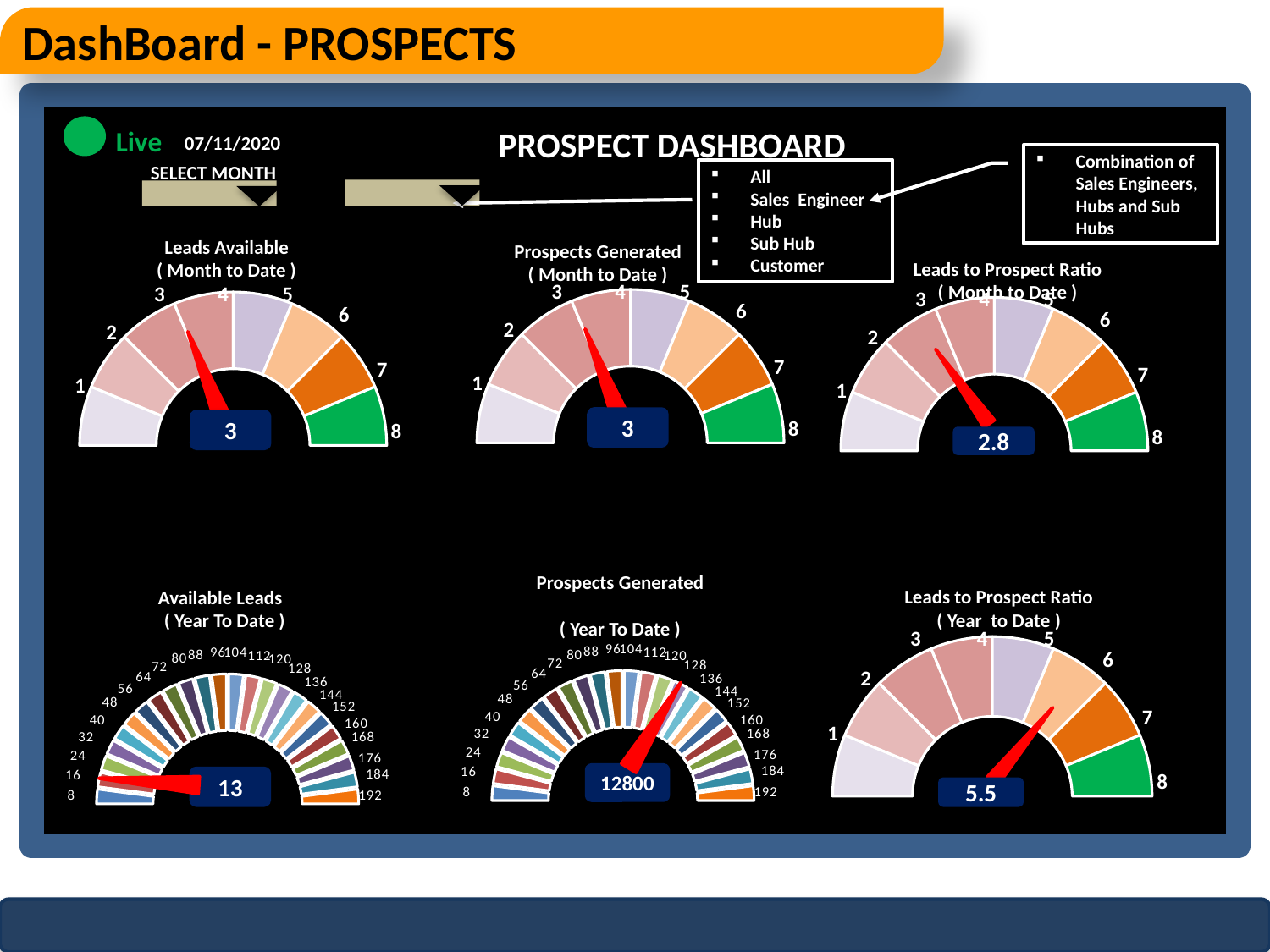
What value is shown on the 'Leads to Prospect Ratio (Month to Date)' gauge? 2.8 What kind of chart is used to display the values on this dashboard? Gauge chart What value is shown on the 'Leads to Prospect Ratio (Year to Date)' gauge? 5.5 What is the difference between the Year to Date and Month to Date Leads to Prospect Ratio values? 2.7 Among the three Month to Date gauges in the top row, which shows the lowest value? Leads to Prospect Ratio What value is shown on the 'Leads Available (Month to Date)' gauge? 3 Which is larger: the Leads to Prospect Ratio for Month to Date or for Year to Date? Year to Date What value is shown on the 'Available Leads (Year To Date)' gauge? 13 What is the highest tick value on the scale of the 'Prospects Generated (Year To Date)' gauge? 192 What value is shown on the 'Prospects Generated (Month to Date)' gauge? 3 How many gauge charts are shown on the slide? 6 What value is shown on the 'Prospects Generated (Year To Date)' gauge? 12800